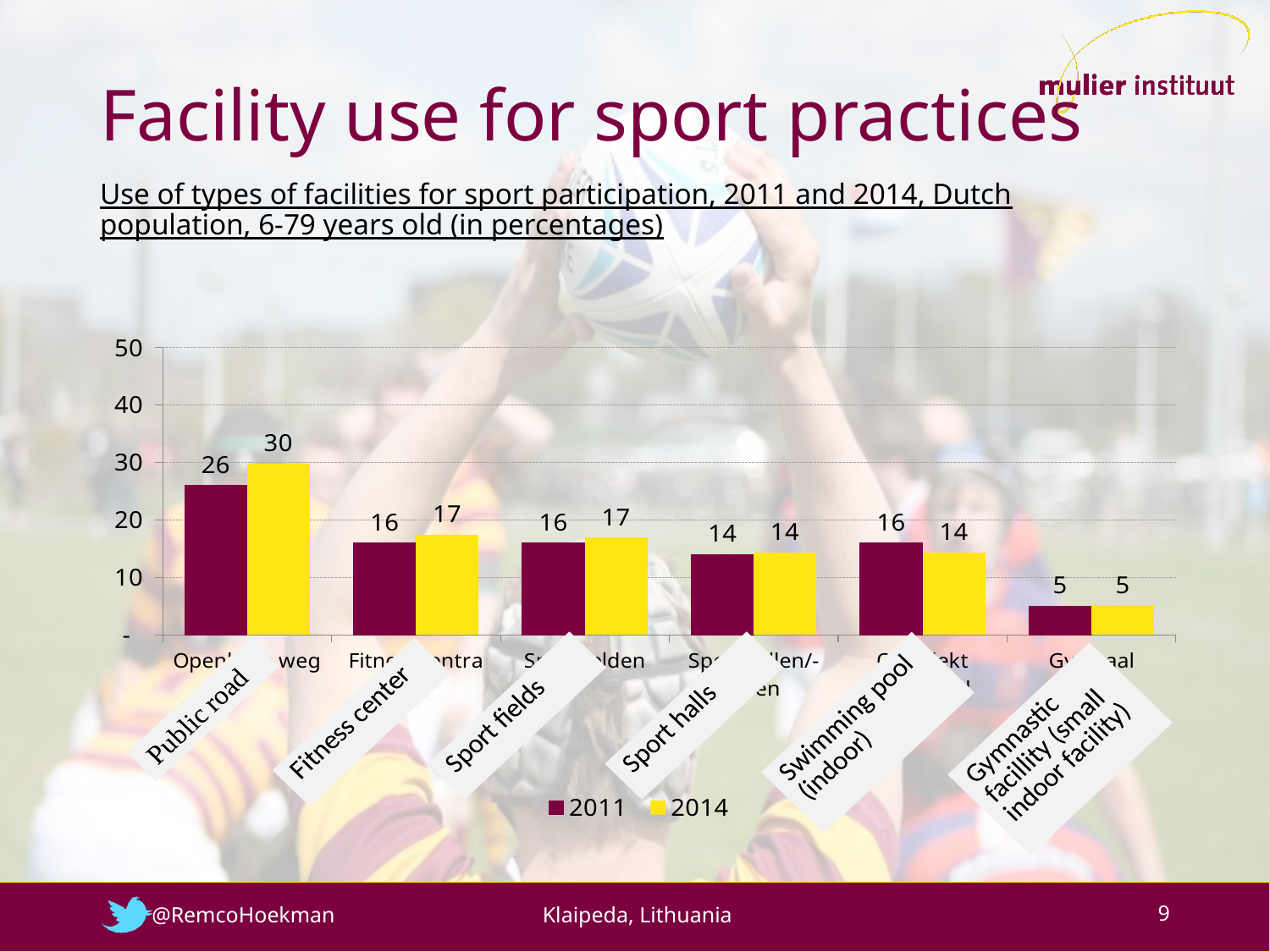
Which facility type has the lowest 2011 value? Gymnastic facility (small indoor facility) What is the 2011 value for Public road? 26 What is the difference between the 2014 and 2011 values for Public road? 4 What is the 2014 value for Swimming pool (indoor)? 14 Is the 2011 value for Public road greater or less than 20? greater What is the 2011 value for Gymnastic facility (small indoor facility)? 5 How many series does the legend list? 2 What is the 2014 value for Public road? 30 Which facility type has the highest 2014 value? Public road What kind of chart is shown on the slide? Bar chart For Swimming pool (indoor), which year has the larger value, 2011 or 2014? 2011 How many facility types are shown on the x axis? 6